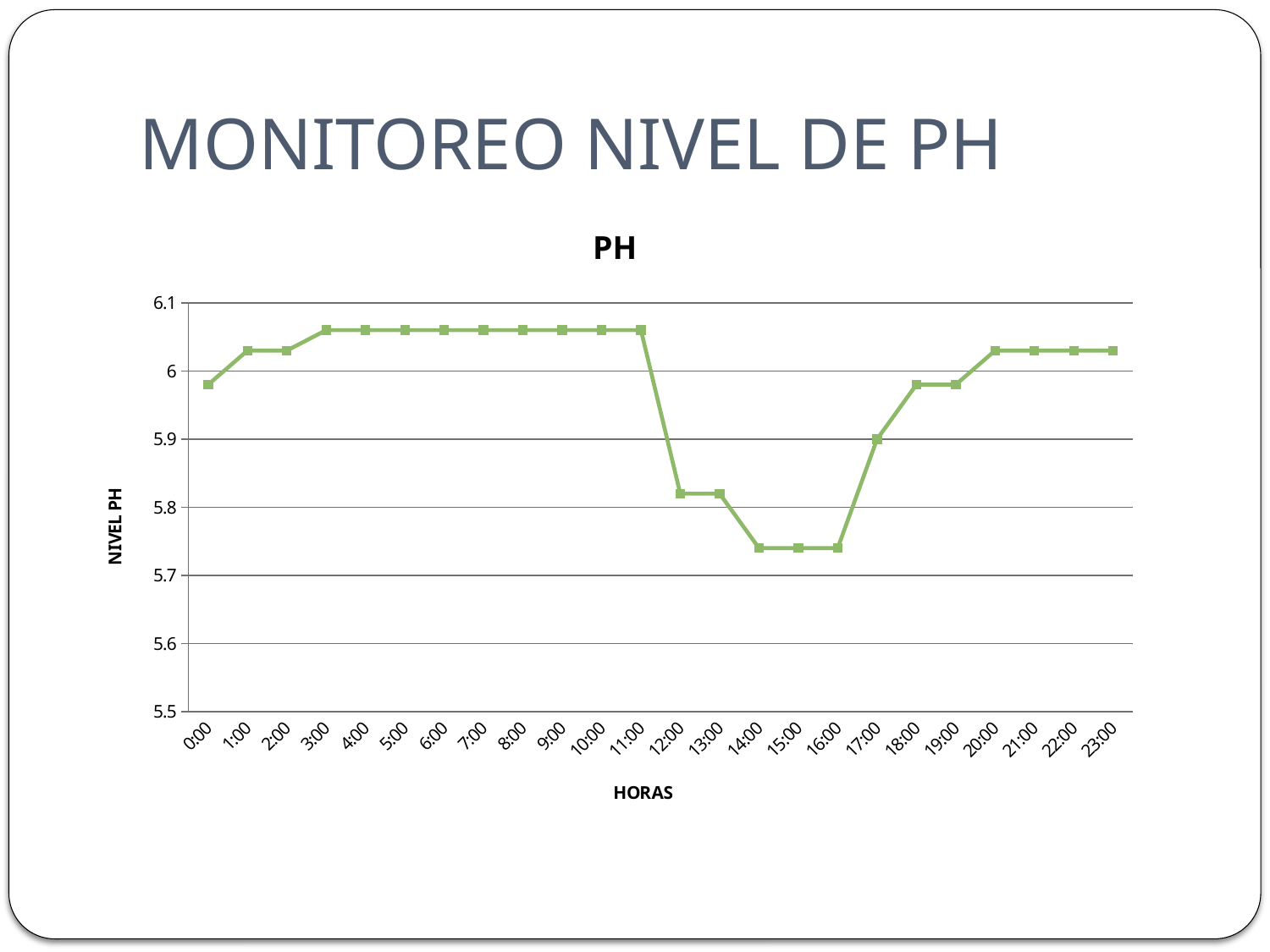
Do the values rise or fall between 11:00 and 14:00? fall What is the title of the chart? PH Which has the higher pH value, 5:00 or 15:00? 5:00 Is the value at 21:00 greater or less than 6? greater Is the value at 3:00 greater or less than 6? greater Is the value at 14:00 greater or less than 5.8? less What is the label of the horizontal axis? HORAS What kind of chart is shown on the slide? line chart How many hourly data points are plotted on the chart? 24 What is the pH value at 17:00? 5.9